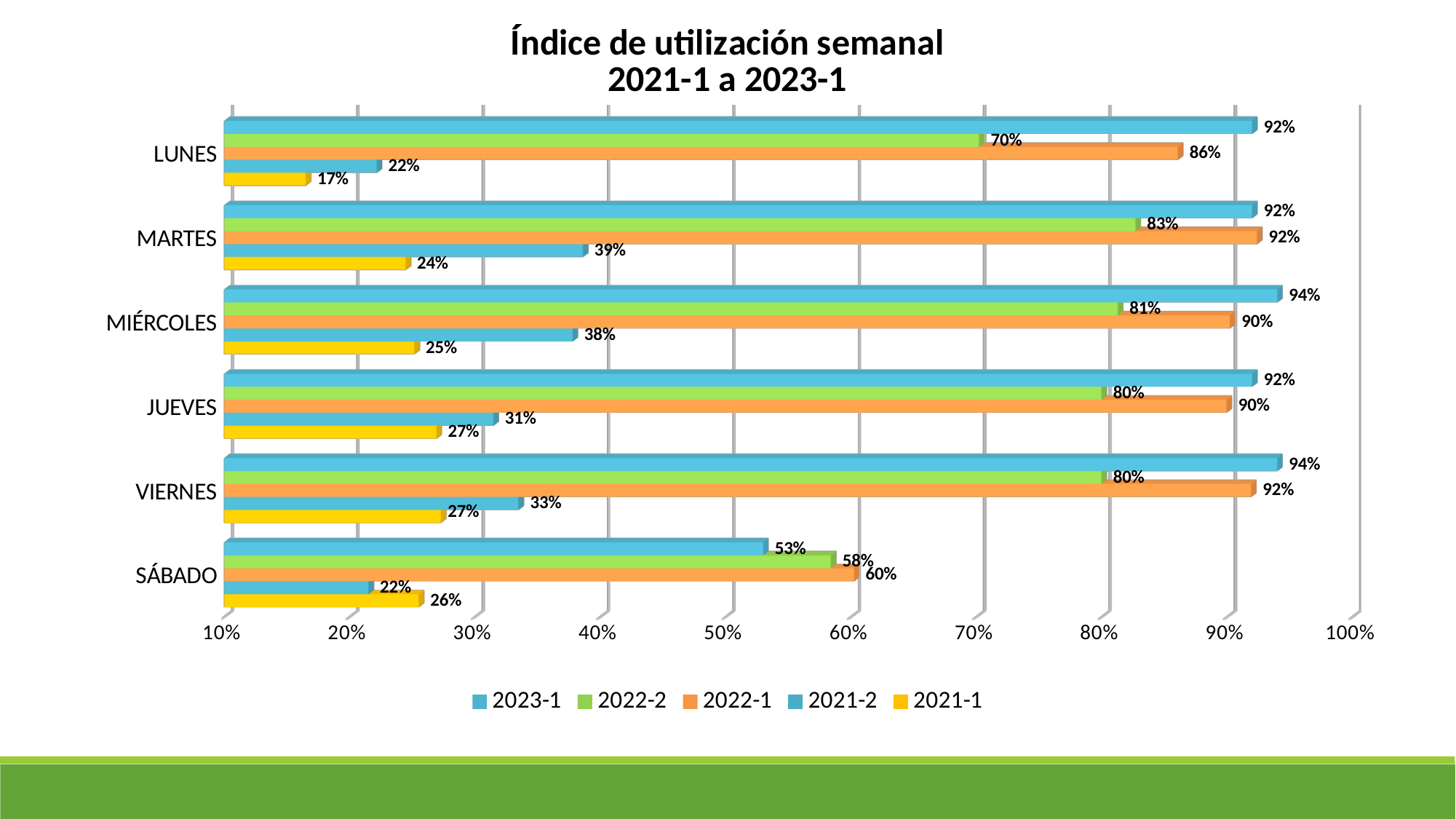
What is the value for LUNES in the 2022-1 series? 86% Is the value for JUEVES in the 2022-2 series greater or less than 70%? greater For SÁBADO, which is larger: the 2022-1 value or the 2023-1 value? 2022-1 What is the value for SÁBADO in the 2023-1 series? 53% How many series does the legend list? 5 How many days (categories) are shown on the chart? 6 Which day has the lowest value in the 2023-1 series? SÁBADO What is the title of the chart? Índice de utilización semanal 2021-1 a 2023-1 What is the value for MARTES in the 2021-2 series? 39% What type of chart is shown on the slide? bar chart What is the difference between the 2023-1 and 2021-1 values for LUNES? 75% Which day has the lowest value in the 2021-1 series? LUNES